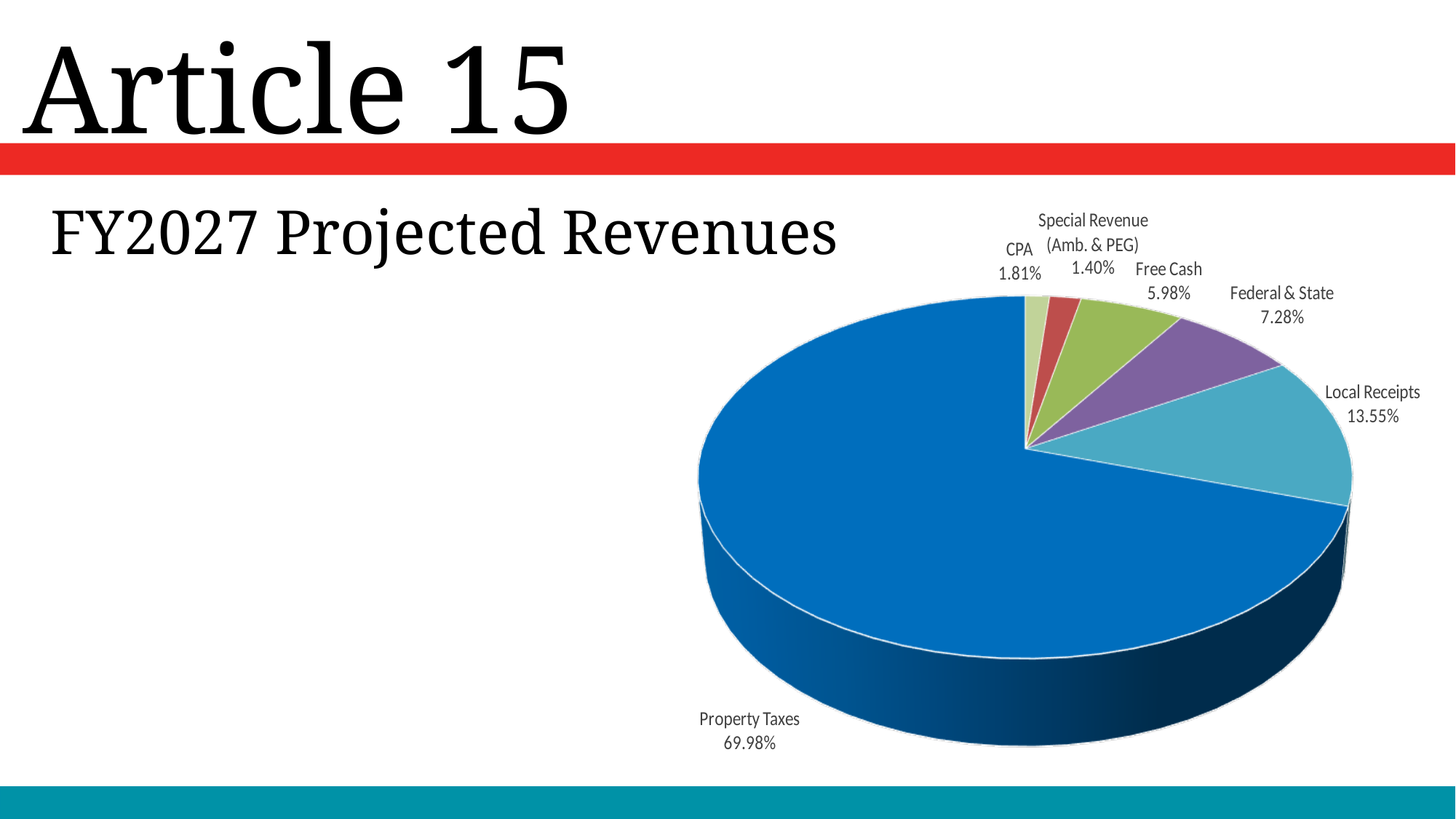
Which category has the smallest share of the pie? Special Revenue (Amb. & PEG) What share of FY2027 projected revenues comes from Property Taxes? 69.98% What kind of chart is shown on the slide? Pie chart What percentage is shown for Special Revenue (Amb. & PEG)? 1.40% What percentage is shown for Free Cash? 5.98% What is the value shown for CPA? 1.81% Which category has the largest share of the pie? Property Taxes What percentage of the pie is Local Receipts? 13.55% What is the value shown for Federal & State? 7.28% What is the difference in percentage points between Local Receipts and Federal & State? 6.27 Which is larger, Free Cash or CPA? Free Cash How many categories are shown in the pie chart? 6